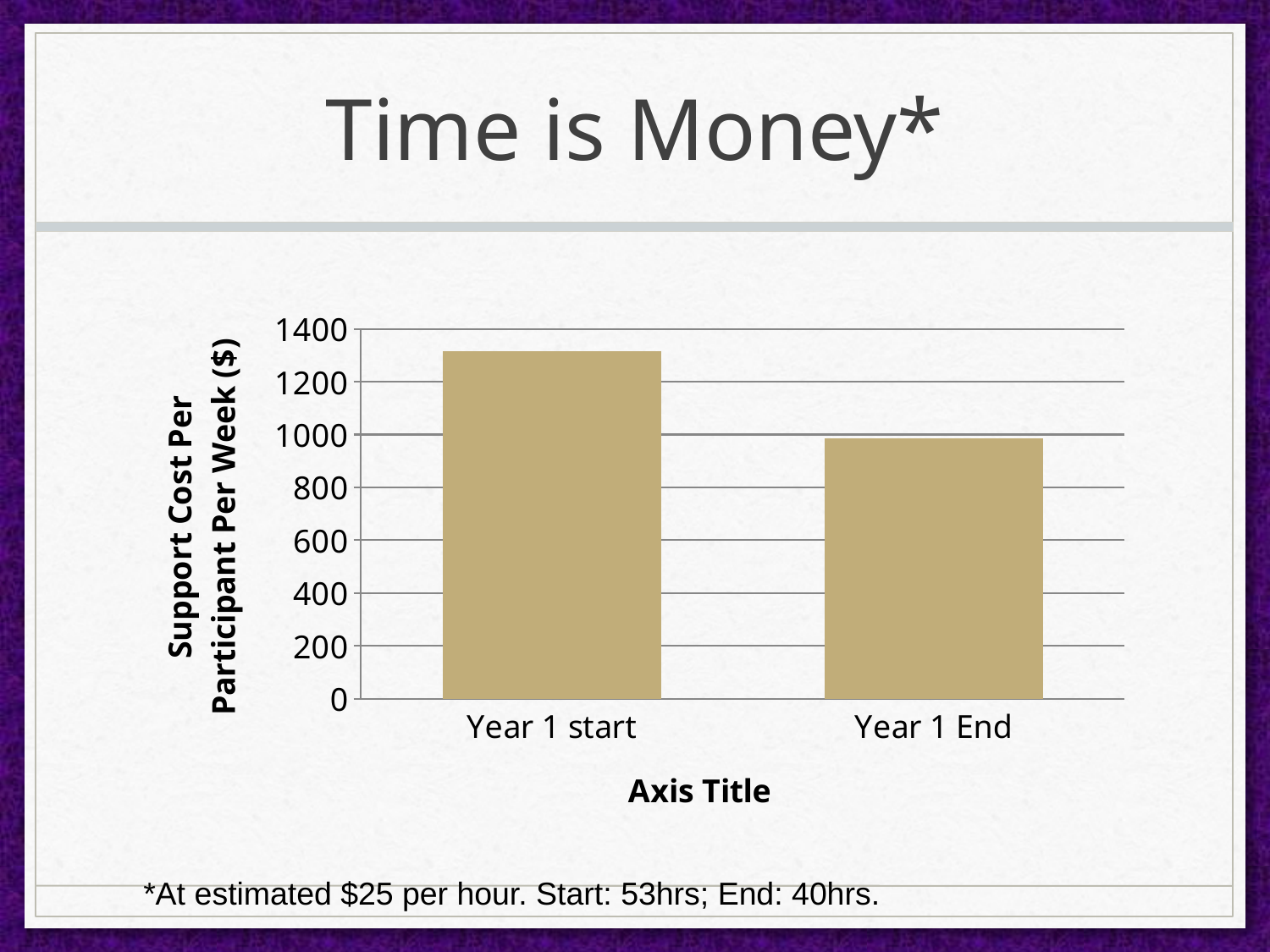
Which category has the lowest support cost per participant per week? Year 1 End Is the value for Year 1 End greater or less than 1200? less Is the value for Year 1 start greater or less than 1200? greater Do the values rise or fall from Year 1 start to Year 1 End? fall Is the value for Year 1 End greater or less than 800? greater What kind of chart is shown on the slide? bar chart How many categories are plotted on the x axis? 2 What is the title of the slide? Time is Money* Which category has the highest support cost per participant per week? Year 1 start Which is larger, the value for Year 1 start or the value for Year 1 End? Year 1 start What is the title of the vertical axis? Support Cost Per Participant Per Week ($)